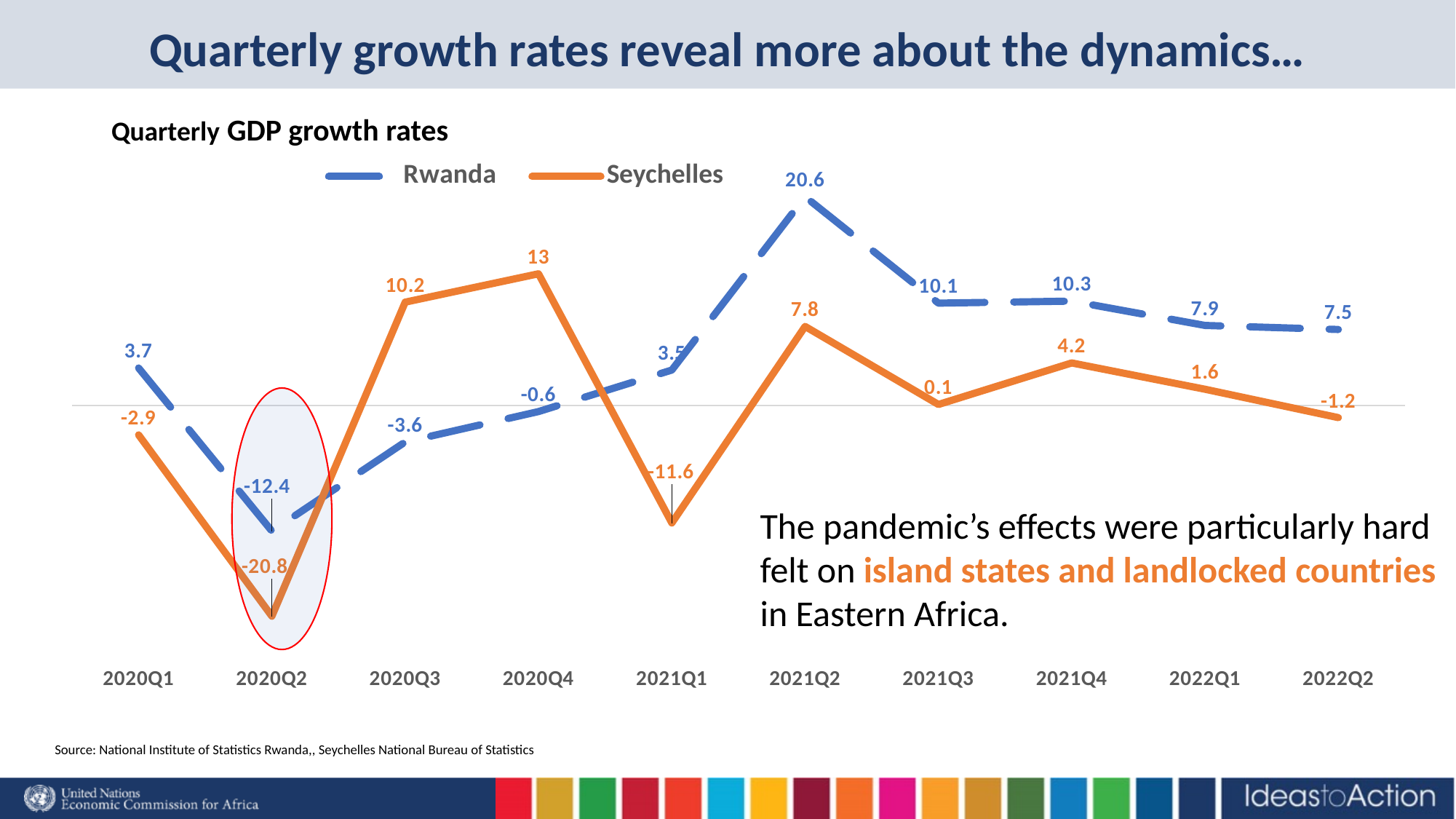
What is the Seychelles growth rate in 2020Q4? 13 What kind of chart is shown on the slide? line chart In which quarter does Seychelles reach its lowest growth rate? 2020Q2 Which series has the higher value in 2020Q3, Rwanda or Seychelles? Seychelles Does the Rwanda growth rate rise or fall from 2021Q2 to 2022Q2? fall How many series does the legend list? 2 In which quarter does Rwanda reach its highest growth rate? 2021Q2 How many quarters are plotted along the x axis? 10 What is the Rwanda growth rate in 2021Q2? 20.6 What is the Seychelles growth rate in 2020Q2? -20.8 What is the title of the chart? Quarterly GDP growth rates What is the difference between the Rwanda and Seychelles growth rates in 2021Q4? 6.1